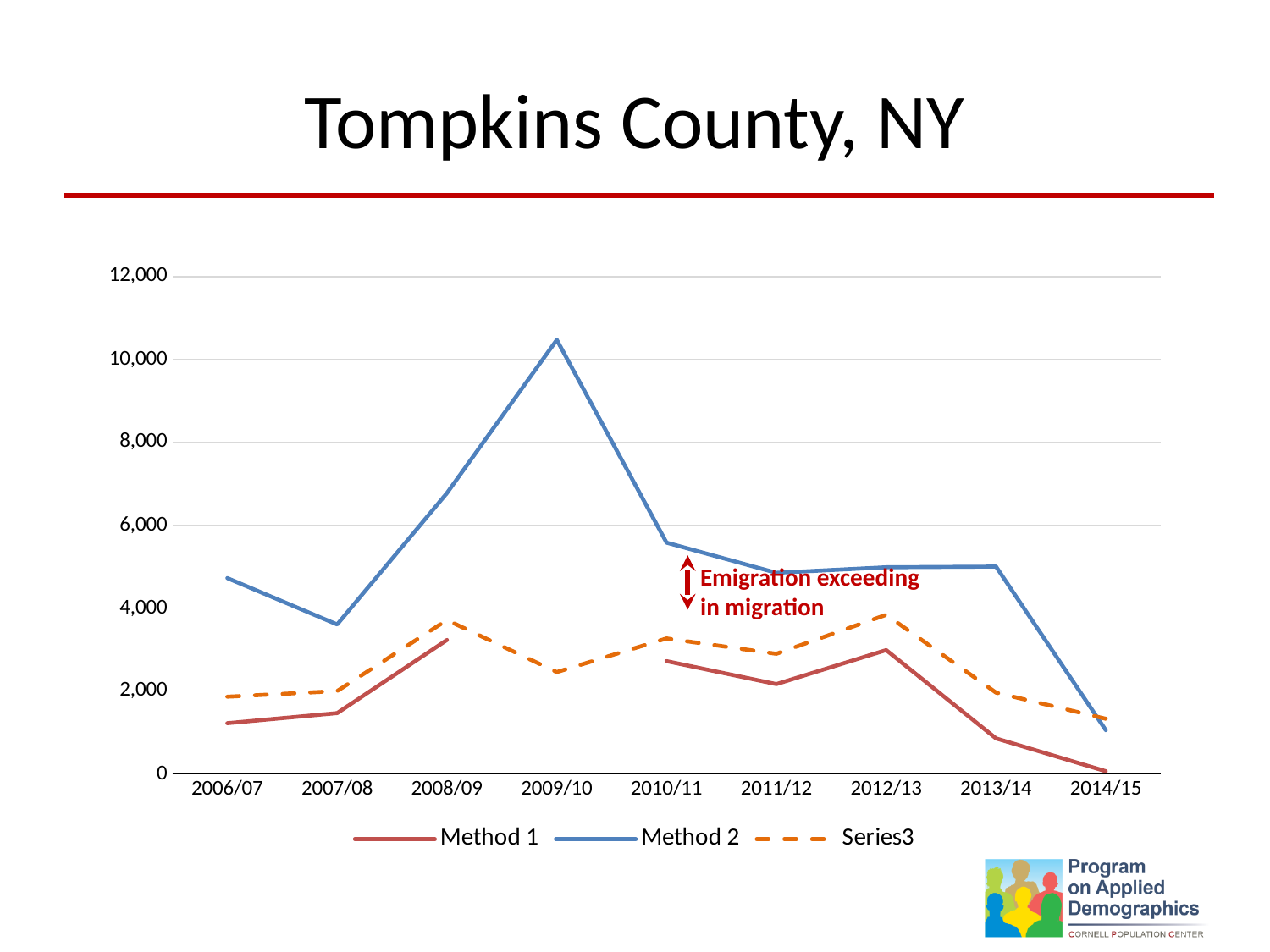
Do the Method 2 values rise or fall from 2009/10 to 2014/15? Fall Is the value for Method 2 in 2014/15 greater or less than 2,000? less Is the value for Method 1 in 2008/09 greater or less than 2,000? greater Which series in the legend is drawn with a dashed line? Series3 In which period does Method 2 reach its lowest value? 2014/15 How many series does the legend list? 3 What kind of chart is shown on the slide? Line chart In which period does Method 2 reach its highest value? 2009/10 How many time periods are shown on the x axis? 9 In which period does Method 1 reach its lowest value? 2014/15 Is the value for Method 2 in 2009/10 greater or less than 10,000? greater